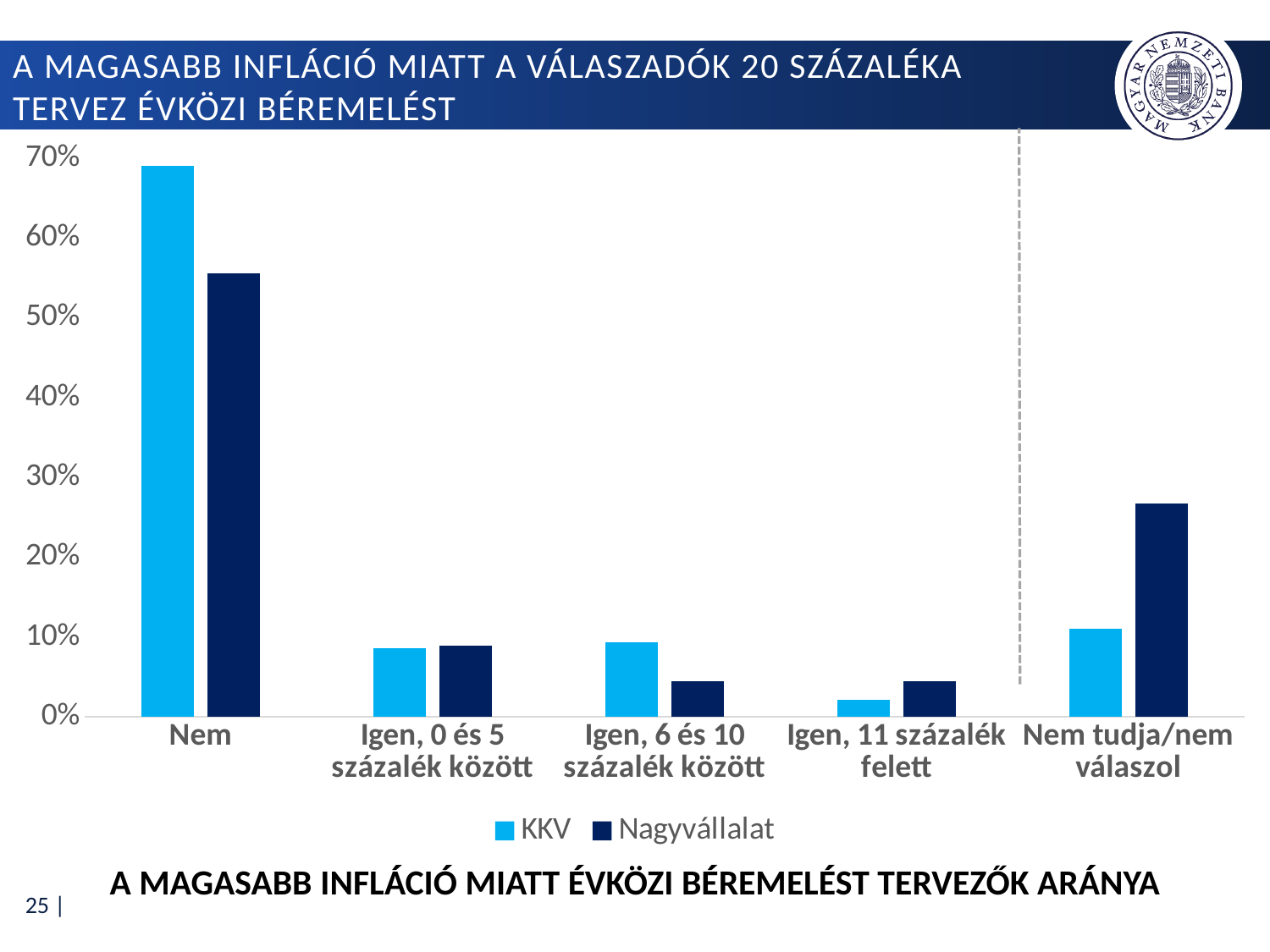
Which category has the lowest value for the KKV series? Igen, 11 százalék felett For 'Igen, 6 és 10 százalék között', which series has the larger value, KKV or Nagyvállalat? KKV What kind of chart is shown on the slide? bar chart How many categories are shown on the x axis? 5 Which category has the highest value for the Nagyvállalat series? Nem Which category has the highest value for the KKV series? Nem How many series does the legend list? 2 For 'Nem tudja/nem válaszol', which series has the larger value, KKV or Nagyvállalat? Nagyvállalat Is the Nagyvállalat value for 'Nem tudja/nem válaszol' greater or less than 20%? greater Is the Nagyvállalat value for 'Nem' greater or less than 60%? less What are the two series named in the legend? KKV and Nagyvállalat Is the KKV value for 'Nem' greater or less than 60%? greater